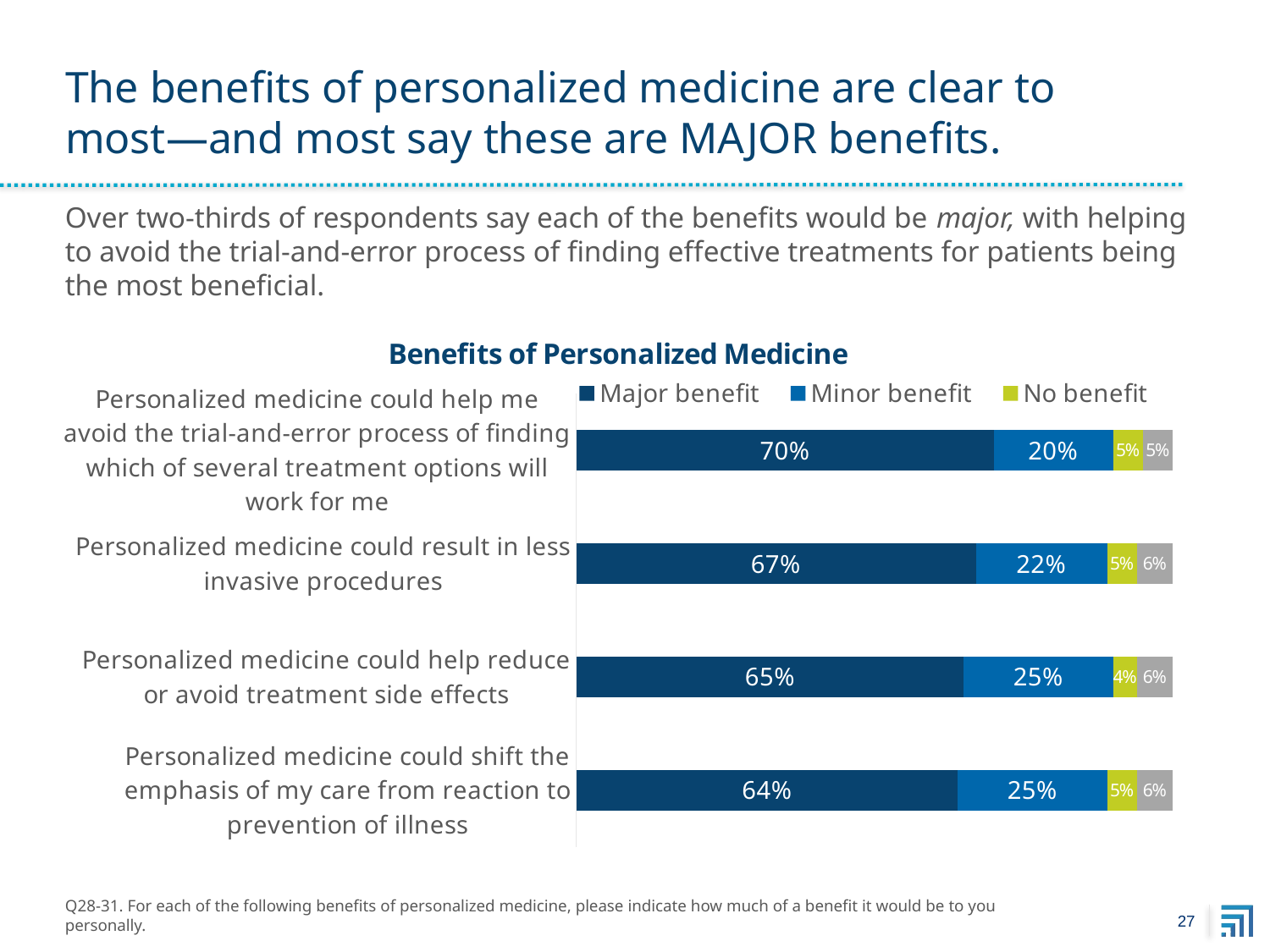
What is the No benefit value for "Personalized medicine could help reduce or avoid treatment side effects"? 4% Which benefit has the highest Major benefit value? Personalized medicine could help me avoid the trial-and-error process of finding which of several treatment options will work for me What is the Major benefit value for "Personalized medicine could shift the emphasis of my care from reaction to prevention of illness"? 64% How many benefits (categories) are shown in the chart? 4 Which is larger: the Minor benefit value for the less invasive procedures benefit or the Minor benefit value for the treatment side effects benefit? Treatment side effects (25%) Which benefit has the lowest Major benefit value? Personalized medicine could shift the emphasis of my care from reaction to prevention of illness What is the Minor benefit value for "Personalized medicine could result in less invasive procedures"? 22% What is the title of the chart? Benefits of Personalized Medicine What is the Major benefit value for "Personalized medicine could help me avoid the trial-and-error process of finding which of several treatment options will work for me"? 70% What kind of chart is shown on the slide? Stacked bar chart What is the difference between the Major benefit values for the trial-and-error benefit and the less invasive procedures benefit? 3 percentage points How many series does the chart legend list? 3